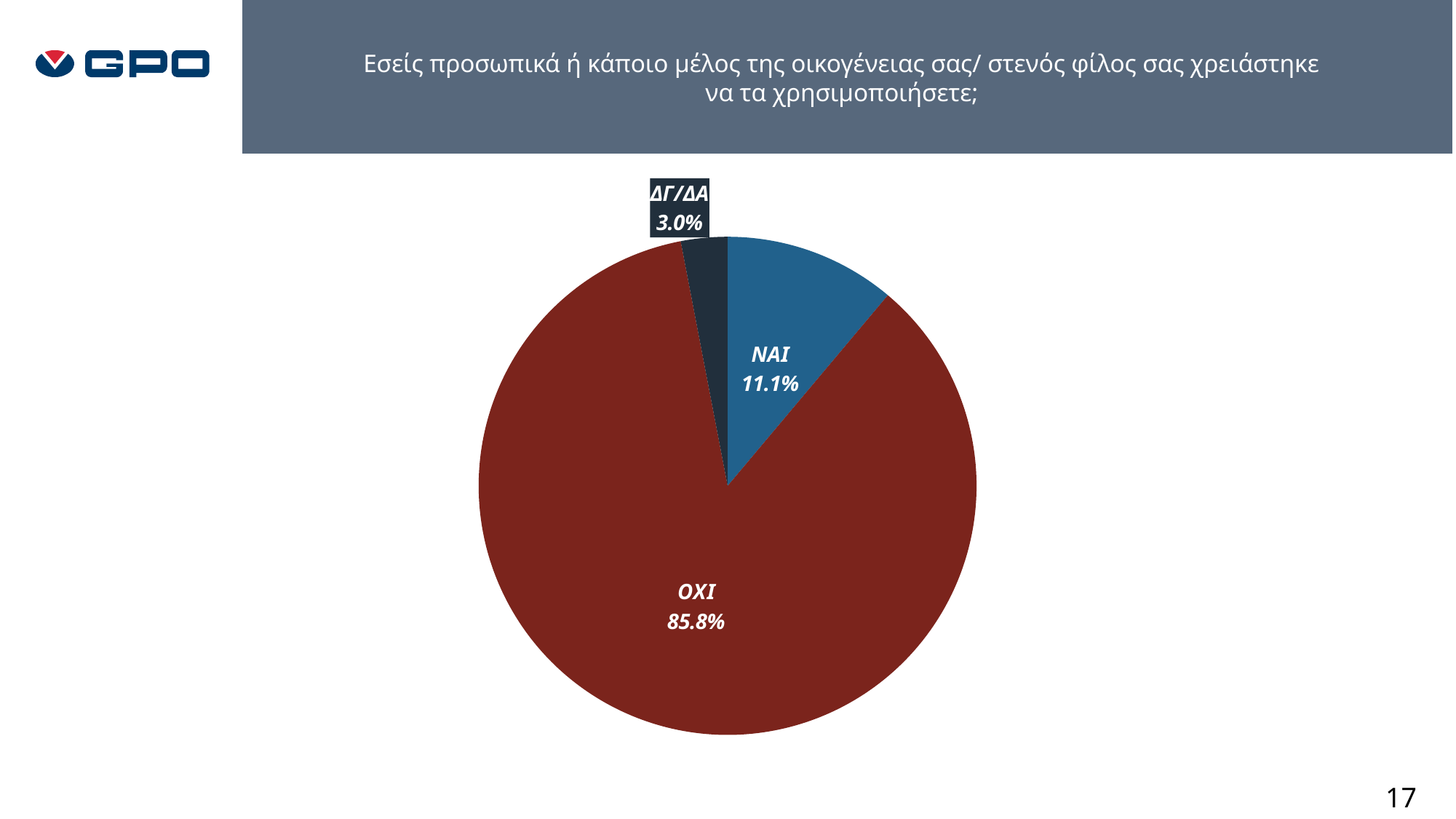
Which slice of the pie is the smallest? ΔΓ/ΔΑ What is the difference in percentage points between ΝΑΙ and ΔΓ/ΔΑ? 8.1 What kind of chart is shown on the slide? pie chart What colour is the ΝΑΙ slice? blue What is the value shown for ΔΓ/ΔΑ? 3.0% How many slices does the pie chart have? 3 Which is larger, the value for ΝΑΙ or the value for ΔΓ/ΔΑ? ΝΑΙ What is the difference in percentage points between ΟΧΙ and ΝΑΙ? 74.7 What colour is the ΟΧΙ slice? dark red What is the value shown for ΝΑΙ? 11.1% What share of the pie does ΟΧΙ take? 85.8% Which slice of the pie is the largest? ΟΧΙ